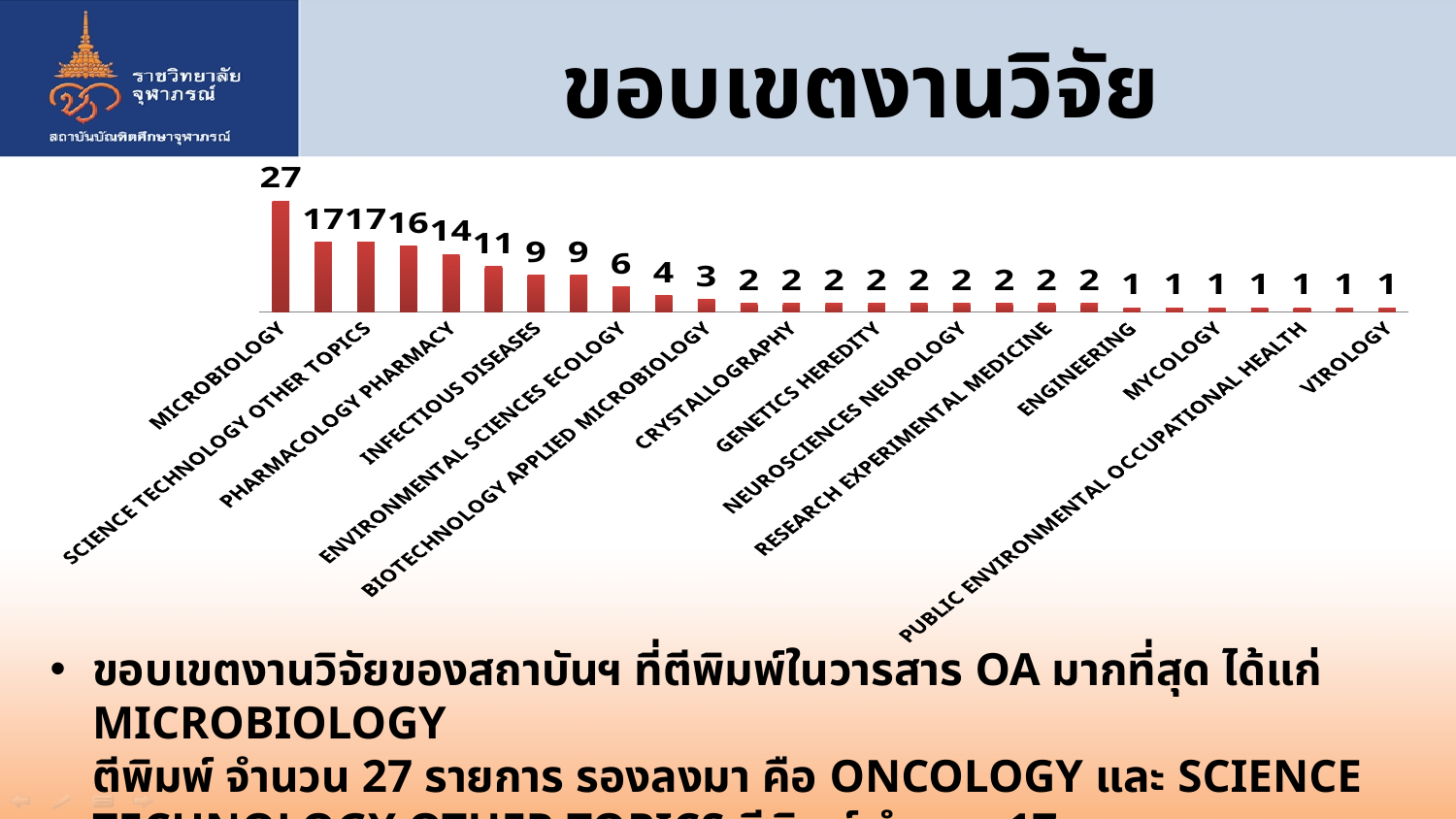
Which is larger, the value for MICROBIOLOGY or the value for PHARMACOLOGY PHARMACY? MICROBIOLOGY What is the highest data label value shown in the chart? 27 How many bars are plotted in the chart? 27 What is the value for SCIENCE TECHNOLOGY OTHER TOPICS? 17 What is the value for PHARMACOLOGY PHARMACY? 14 What is the difference between the values for MICROBIOLOGY and SCIENCE TECHNOLOGY OTHER TOPICS? 10 What kind of chart is shown on the slide? bar chart Do the values rise or fall from left to right along the x axis? fall Which category has the highest value in the chart? MICROBIOLOGY What colour are the bars in the chart? red What is the value for MICROBIOLOGY? 27 What is the value for VIROLOGY? 1